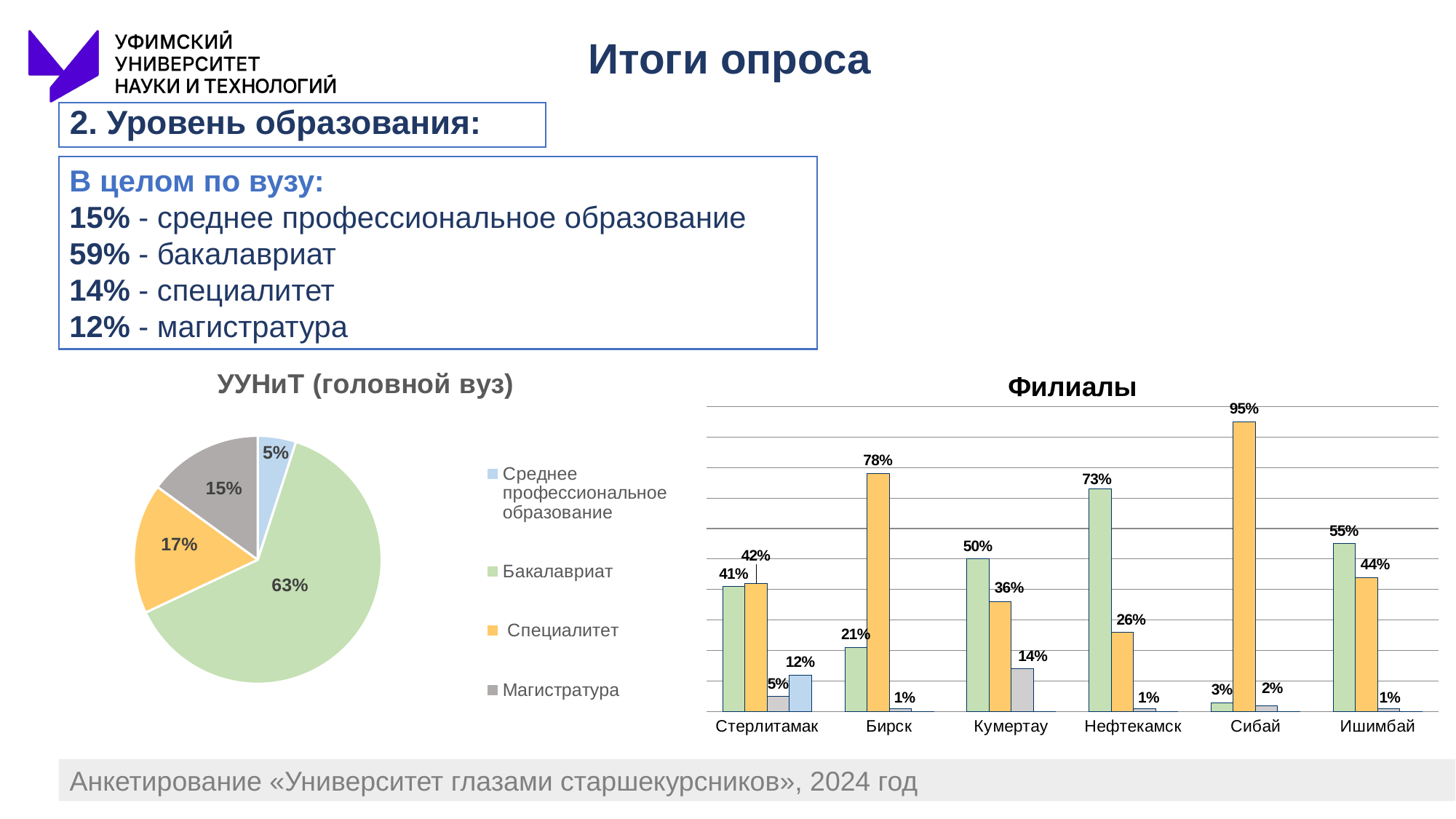
In the bar chart titled «Филиалы», how many branches are shown on the x axis? 6 In the pie chart titled «УУНиТ (головной вуз)», which category has the smallest slice? Среднее профессиональное образование In the bar chart titled «Филиалы», which is larger for Ишимбай: the Бакалавриат bar or the Специалитет bar? Бакалавриат In the bar chart titled «Филиалы», what is the value of the Специалитет (orange) bar for Сибай? 95% In the pie chart titled «УУНиТ (головной вуз)», how many slices are there? 4 In the bar chart titled «Филиалы», which branch has the highest Бакалавриат (green) value? Нефтекамск What type of chart is the one titled «Филиалы»? Bar chart In the pie chart titled «УУНиТ (головной вуз)», what share is shown for Бакалавриат? 63% In the pie chart titled «УУНиТ (головной вуз)», what share is shown for Специалитет? 17% In the pie chart titled «УУНиТ (головной вуз)», what is the difference between the Магистратура share and the Среднее профессиональное образование share? 10% In the bar chart titled «Филиалы», what is the value of the Бакалавриат (green) bar for Нефтекамск? 73% In the bar chart titled «Филиалы», what is the difference between the Специалитет and Бакалавриат values for Бирск? 57%